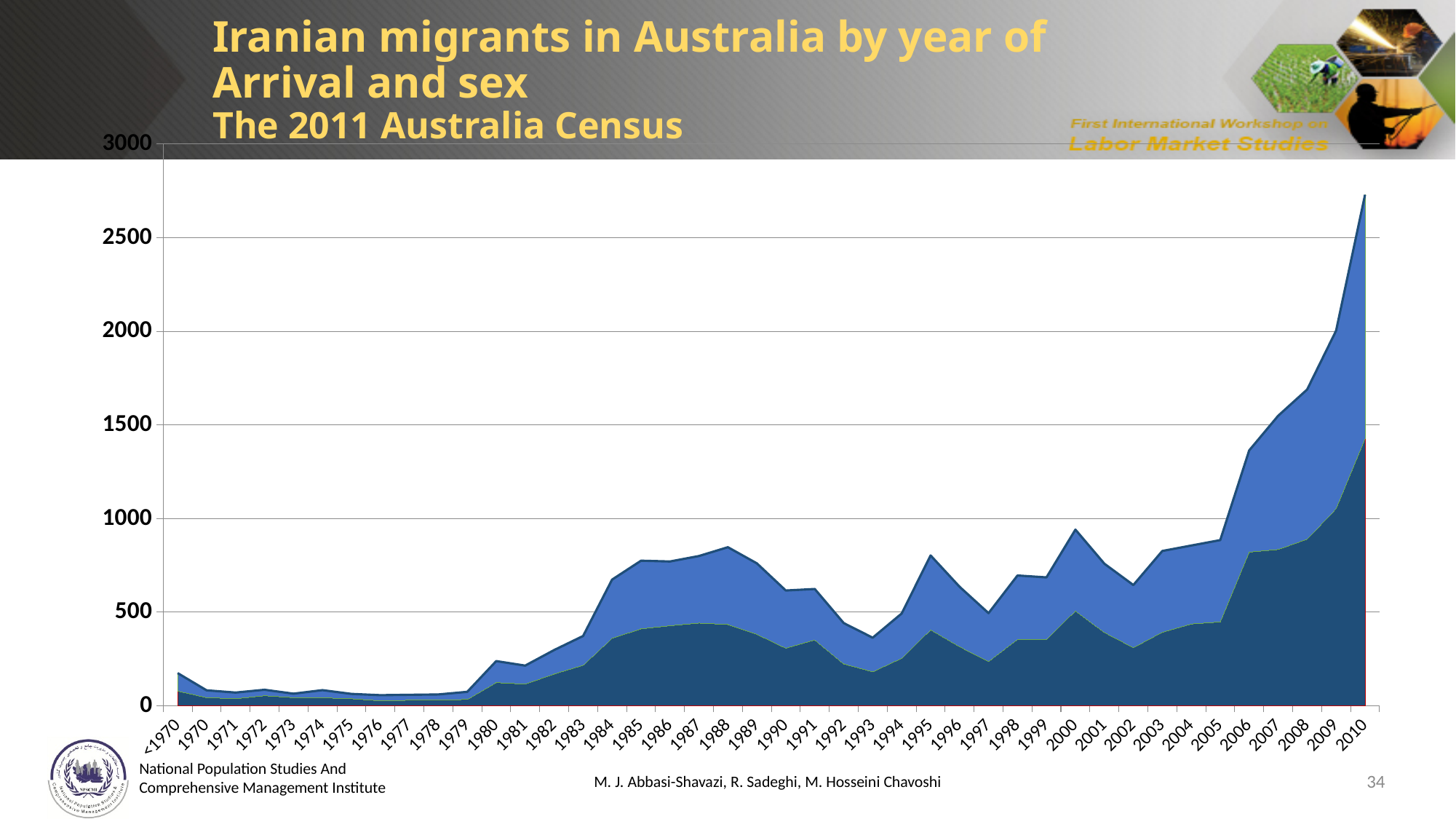
Is the total value for 1995 greater or less than 500? greater Is the total value for 1993 greater or less than 500? less Is the total value for 2006 greater or less than 1000? greater Which year of arrival has the highest total number of Iranian migrants? 2010 Which year has a larger total value, 1985 or 1993? 1985 Do the total values rise or fall from 2005 to 2010? rise Which census is the chart's data taken from, according to the title? The 2011 Australia Census What kind of chart is shown on the slide? Area chart How many year categories are shown along the x axis? 42 Which year has a larger total value, 2009 or 2010? 2010